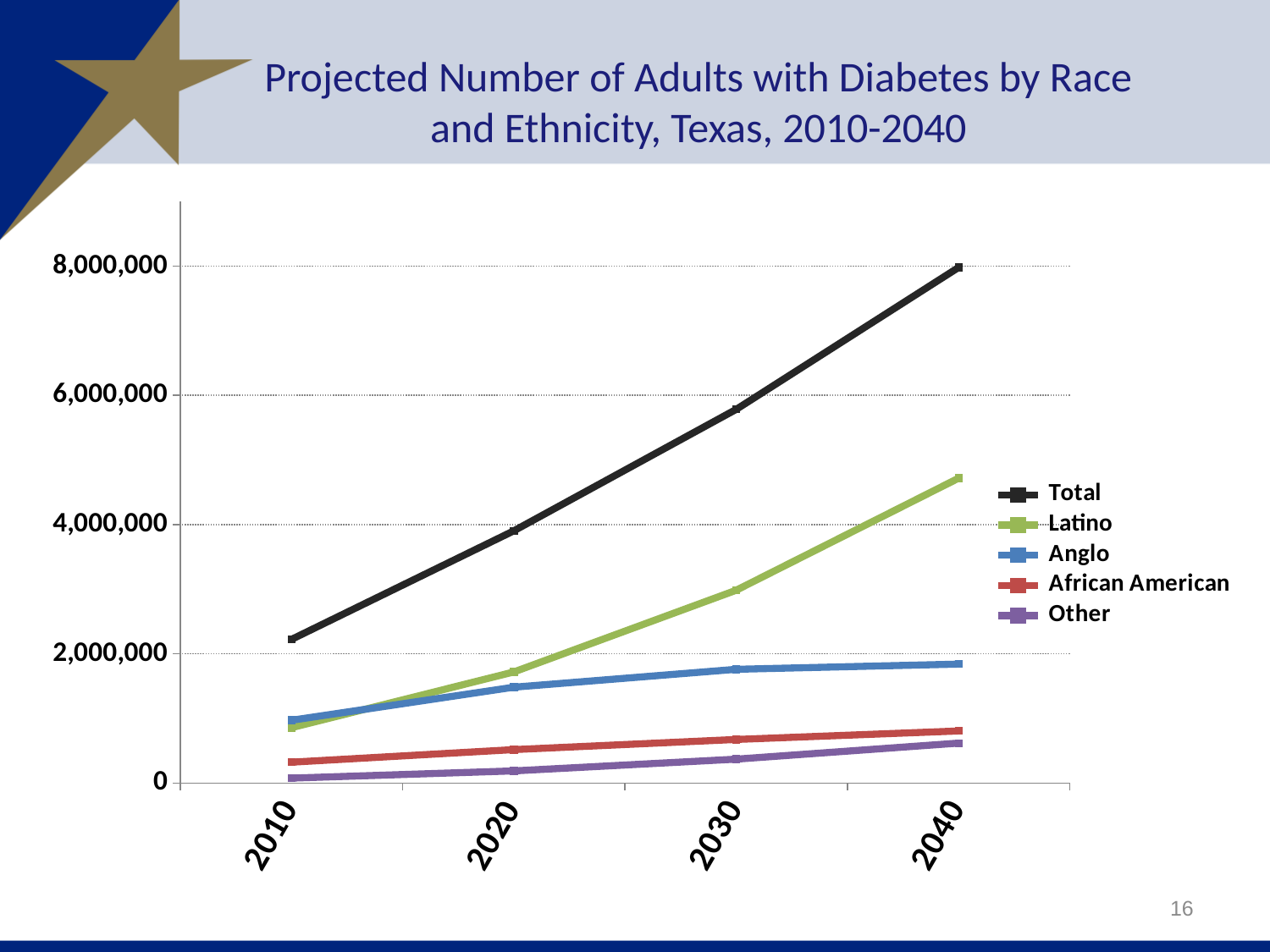
How many series does the legend list? 5 What kind of chart is shown on the slide? line chart In 2040, which is larger, African American or Other? African American Is the value for Latino in 2040 greater or less than 4,000,000? greater Which series has the lowest value in 2040? Other In 2040, which is larger, Latino or Anglo? Latino Does the Total line rise or fall from 2010 to 2040? rise Which series has the highest value in 2040? Total How many years are plotted along the x axis? 4 What is the title of the chart? Projected Number of Adults with Diabetes by Race and Ethnicity, Texas, 2010-2040 Is the value for Anglo in 2040 greater or less than 2,000,000? less Is the value for Total in 2030 greater or less than 6,000,000? less